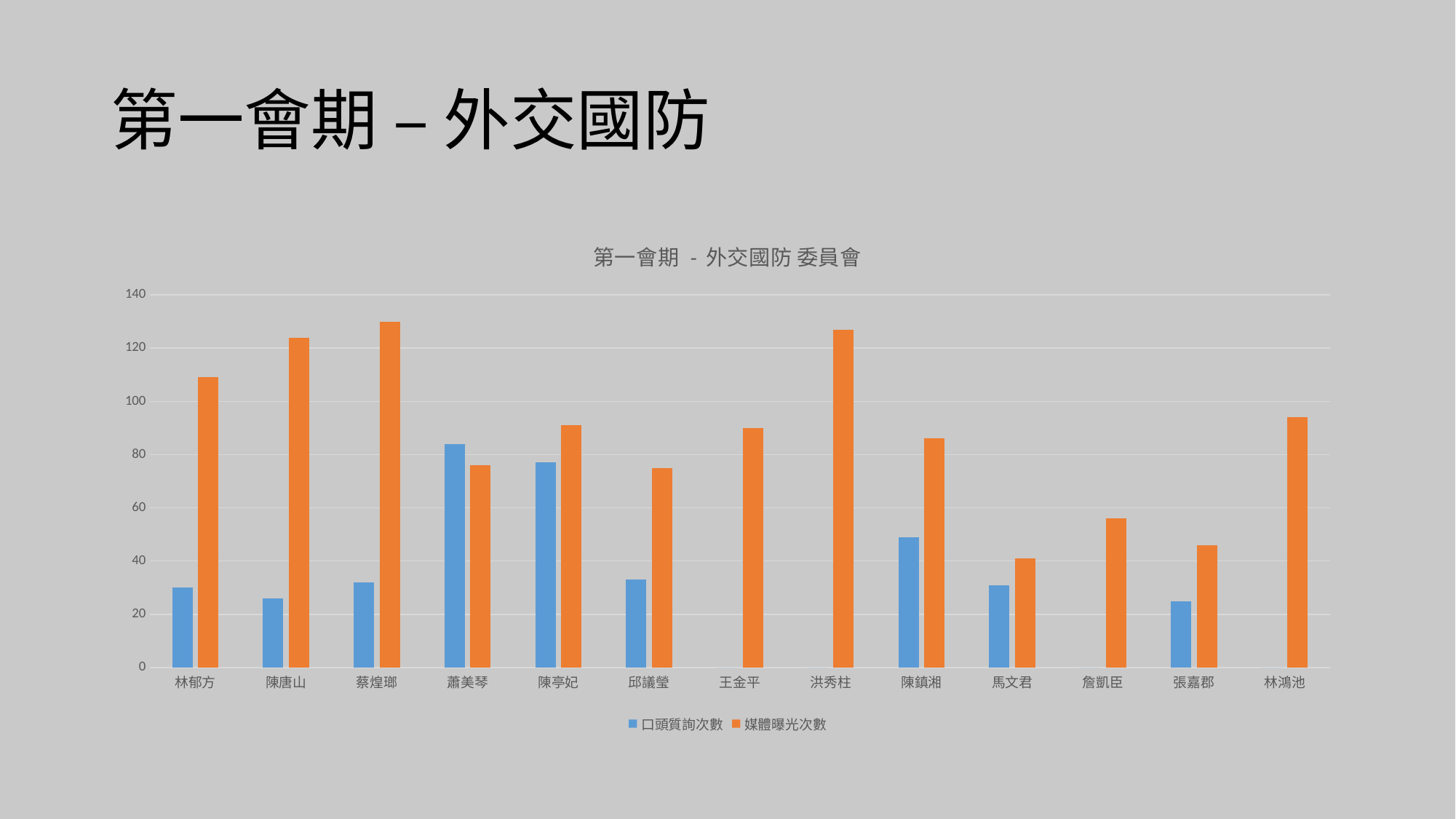
Is the 媒體曝光次數 value for 王金平 greater or less than 100? less Is the 口頭質詢次數 value for 陳鎮湘 greater or less than 40? greater Which category has the highest 口頭質詢次數 value? 蕭美琴 Is the 媒體曝光次數 value for 詹凱臣 greater or less than 60? less For 蕭美琴, which is larger: 口頭質詢次數 or 媒體曝光次數? 口頭質詢次數 How many categories (people) are shown on the x axis? 13 What kind of chart is shown on the slide? bar chart What is the title of the chart? 第一會期 - 外交國防 委員會 Which has the larger 媒體曝光次數 value: 陳唐山 or 邱議瑩? 陳唐山 Which series is shown in orange? 媒體曝光次數 How many series does the legend list? 2